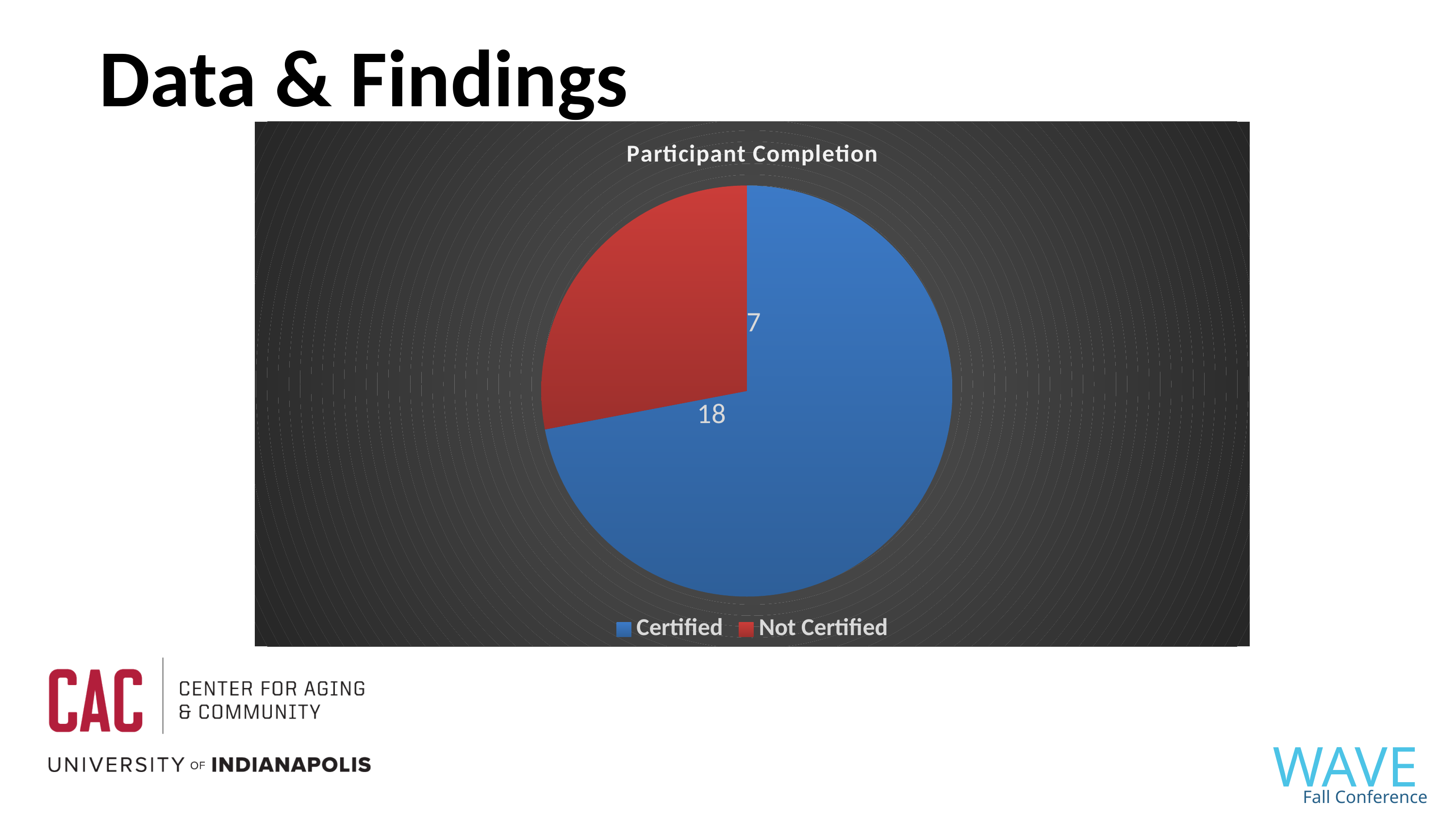
What is the value for Not Certified in the Participant Completion chart? 7 What is the difference between the Certified and Not Certified values? 11 What is the value for Certified in the Participant Completion chart? 18 What is the total of all slices in the Participant Completion chart? 25 What share of the pie does the Certified slice represent? 72% Which is larger, Certified or Not Certified? Certified How many categories are shown in the Participant Completion chart? 2 Which category has the smallest slice in the Participant Completion chart? Not Certified What is the title of the chart? Participant Completion What kind of chart is shown on the slide? Pie chart What colour is the Not Certified slice? Red Which category has the largest slice in the Participant Completion chart? Certified